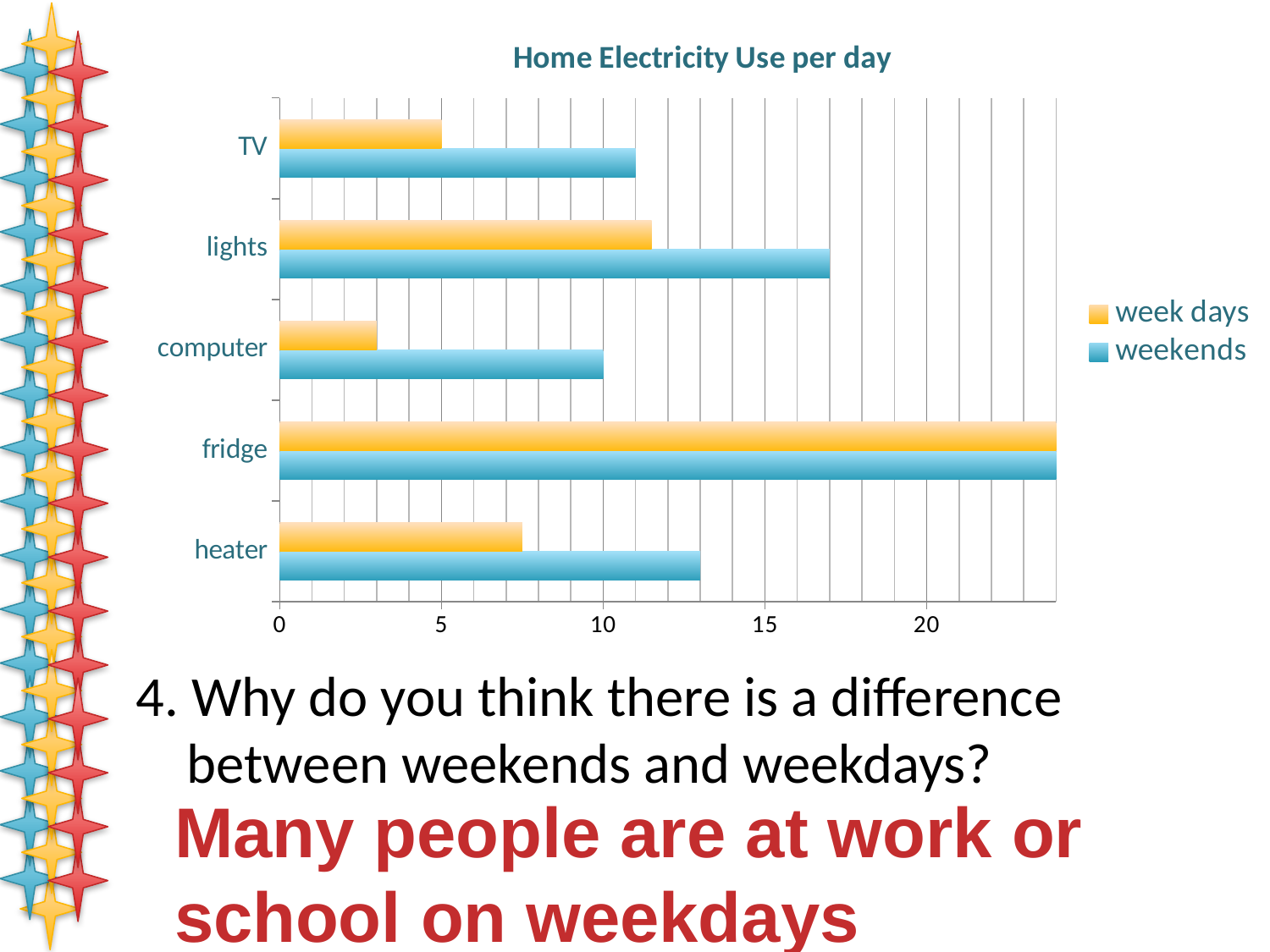
Which is larger, the weekends value for lights or the weekends value for TV? lights Which category has the lowest week days value? computer What is the week days value for TV? 5 How many appliance categories are shown on the chart? 5 What kind of chart is shown on the slide? bar chart Which category has the highest weekends value? fridge What is the weekends value for computer? 10 Is the week days value for heater greater or less than 10? less Is the weekends value for lights greater or less than 15? greater What is the title of the chart? Home Electricity Use per day How many series does the legend list? 2 What colour are the weekends bars? blue